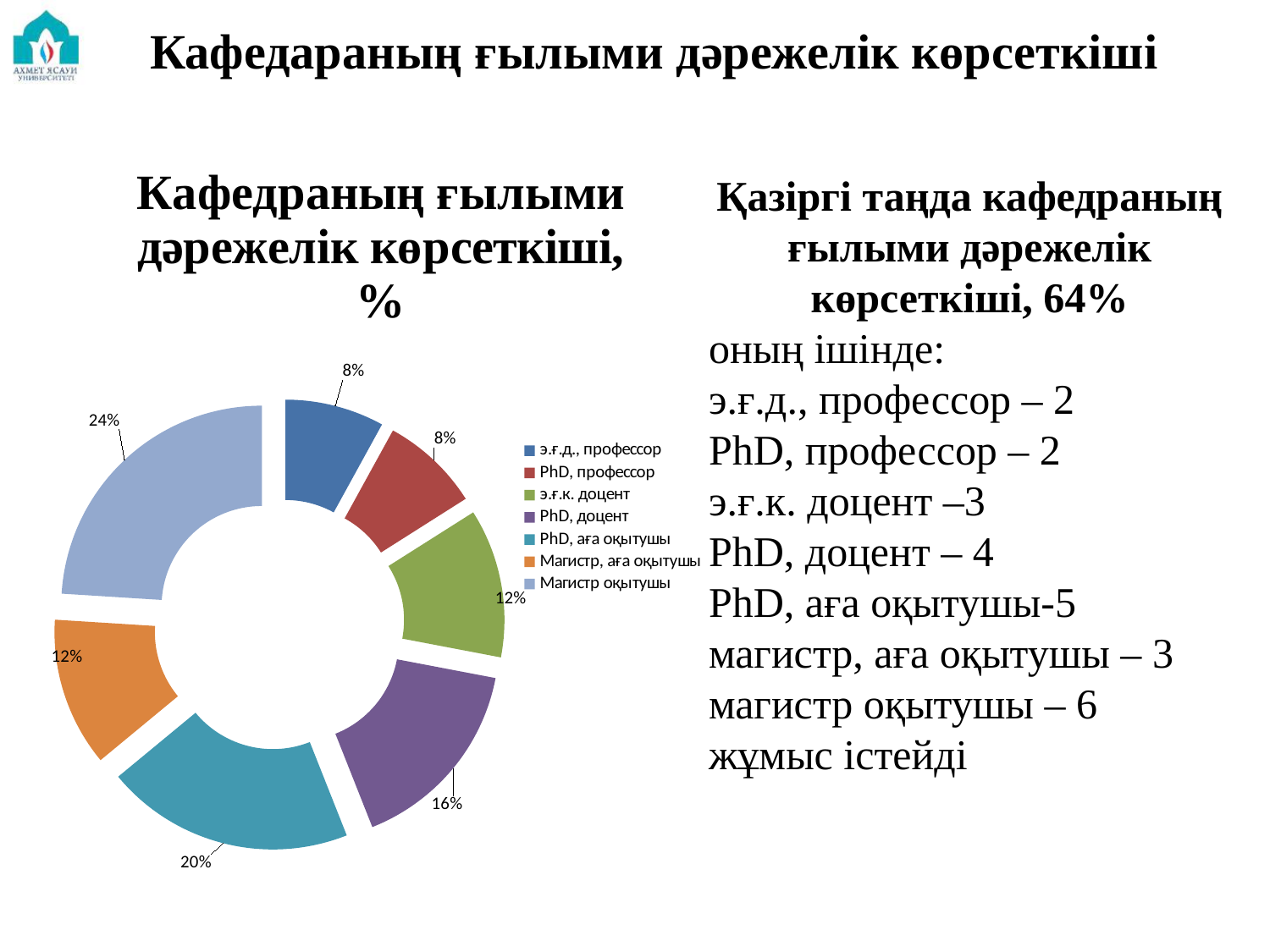
What is the value shown for "PhD, доцент"? 16% What is the title of the chart? Кафедраның ғылыми дәрежелік көрсеткіші, % What is the value shown for "э.ғ.к. доцент"? 12% What colour is the "PhD, профессор" segment in the chart? Red What is the value shown for "PhD, аға оқытушы"? 20% What is the value shown for "э.ғ.д., профессор"? 8% What kind of chart is shown on the slide? Doughnut chart Which category has the largest share in the chart? Магистр оқытушы What is the difference between the shares of "Магистр оқытушы" and "PhD, доцент"? 8% Which is larger: the share for "PhD, аға оқытушы" or the share for "Магистр, аға оқытушы"? PhD, аға оқытушы What share of the doughnut chart does "Магистр оқытушы" hold? 24% How many categories does the chart show? 7